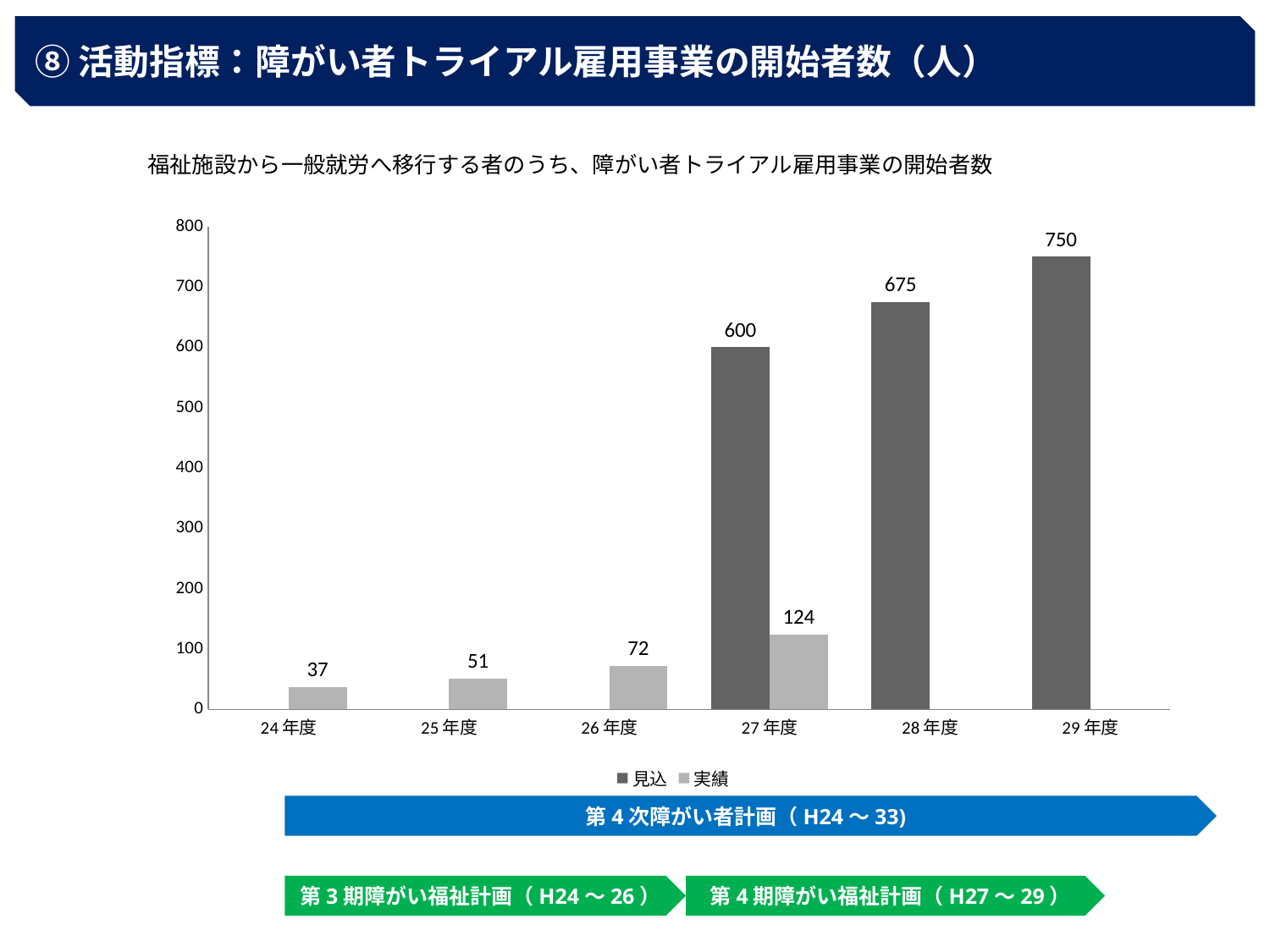
Which is larger, the 実績 value for 25年度 or for 26年度? 26年度 What is the difference between the 見込 values for 28年度 and 27年度? 75 What is the 実績 (actual) value for 24年度? 37 What is the difference between the 見込 and 実績 values for 27年度? 476 What is the 見込 (forecast) value for 29年度? 750 Do the 実績 (actual) values rise or fall from 24年度 to 27年度? Rise What is the 実績 (actual) value for 27年度? 124 Which year has the lowest 実績 (actual) value? 24年度 What kind of chart is shown on the slide? Bar chart Which year has the highest 見込 (forecast) value? 29年度 How many series does the legend list? 2 How many year categories are shown on the x axis? 6